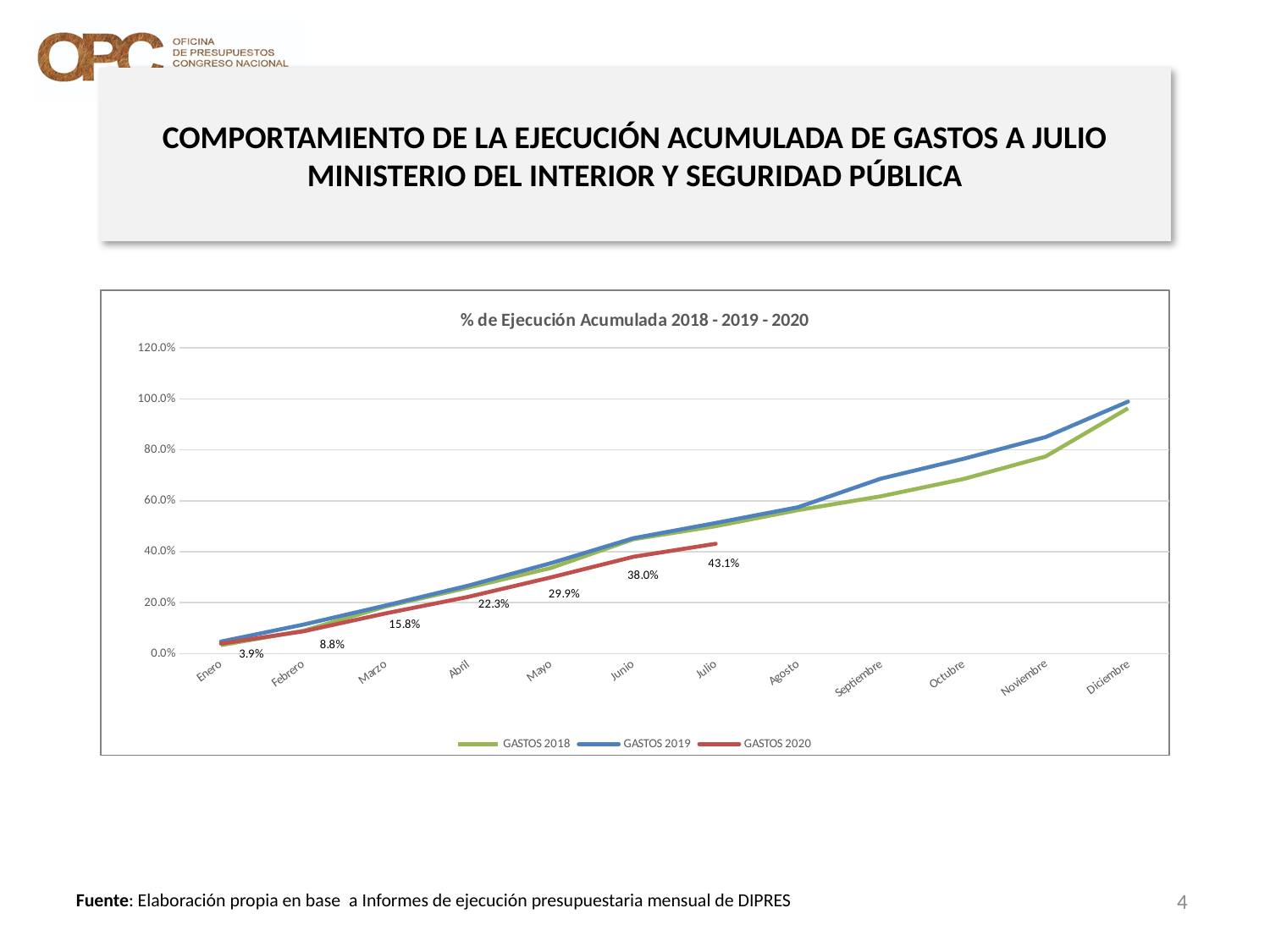
What is the value for GASTOS 2020 in Julio? 43.1% Is the value for GASTOS 2019 in Diciembre greater or less than 80.0%? greater What is the difference between the GASTOS 2020 values for Julio and Junio? 5.1% What is the difference between the GASTOS 2020 values for Mayo and Abril? 7.6% What is the value for GASTOS 2020 in Marzo? 15.8% What is the value for GASTOS 2020 in Junio? 38.0% What kind of chart is shown on the slide? Line chart In which month does GASTOS 2020 reach its highest labelled value? Julio How many series does the legend list? 3 In which month is the GASTOS 2020 value lowest? Enero What is the value for GASTOS 2020 in Enero? 3.9% How many months are shown on the x axis? 12